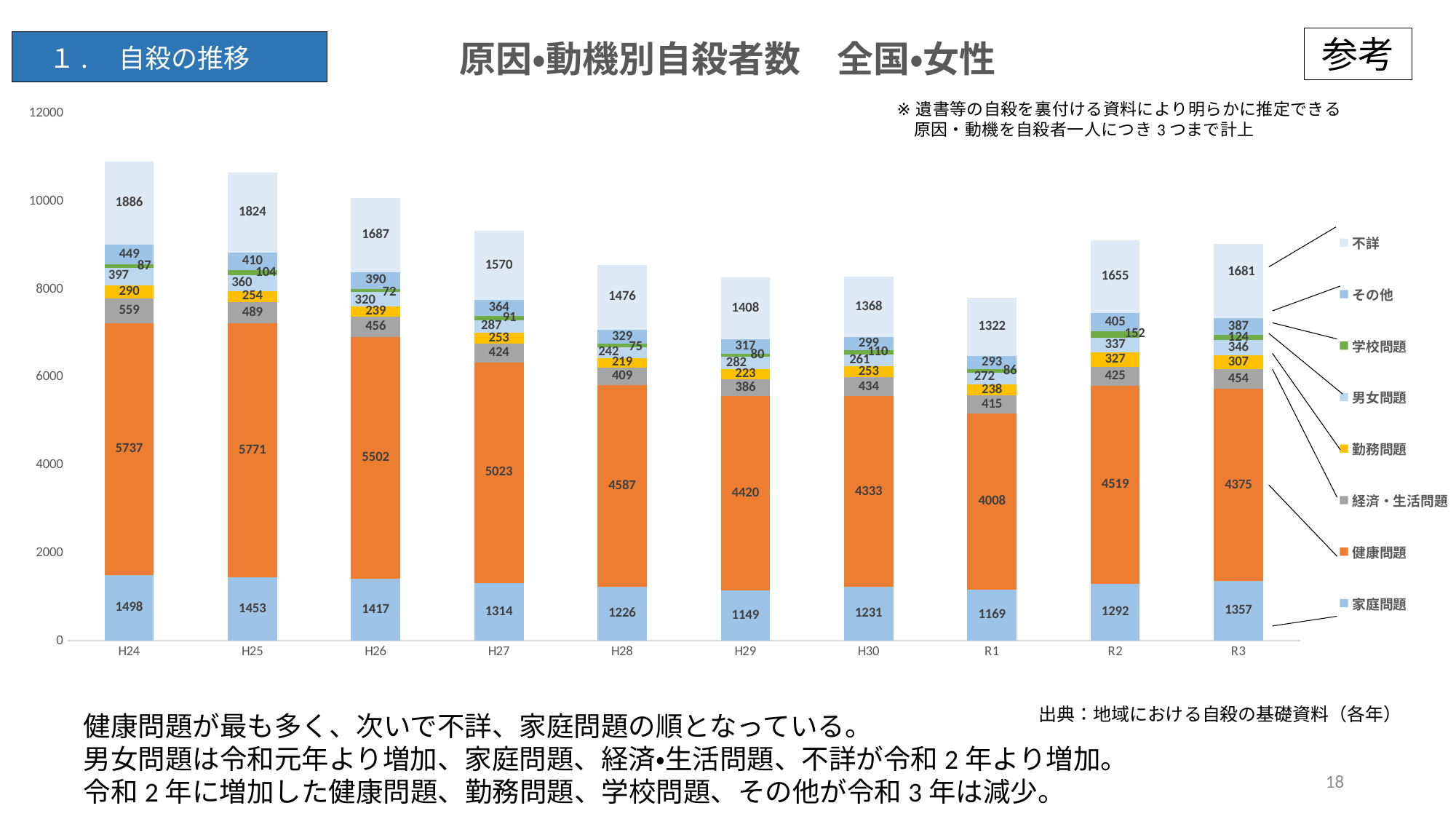
In which year is the 家庭問題 value lowest? H29 What is the difference between the 健康問題 value in H24 and in R3? 1362 What is the total of the stacked bar for H24? 10903 What is the value for 家庭問題 in H29? 1149 In which year is the 健康問題 value highest? H25 What kind of chart is shown? Stacked bar chart How many series does the legend list? 8 Which is larger, the 不詳 value in H24 or in H25? H24 What is the value for 健康問題 in H24? 5737 What is the value for 勤務問題 in R2? 327 What is the value for 不詳 in R3? 1681 How many years are shown on the x axis? 10